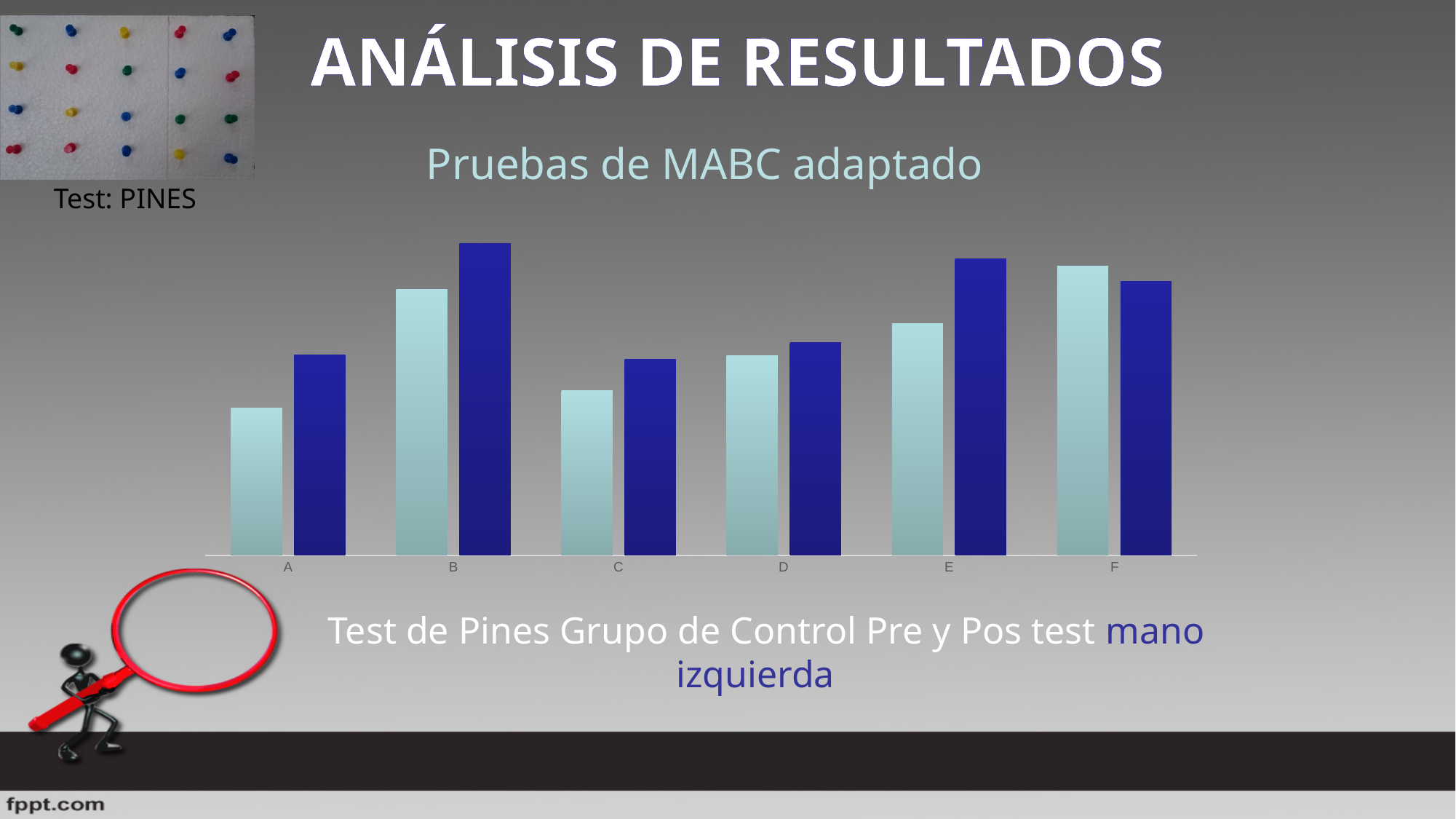
What kind of chart is shown on the slide? bar chart How many bars are plotted for each category in the chart? 2 How many bars are plotted in total in the chart? 12 In category A, which bar is taller, the light blue one or the dark blue one? dark blue What are the labels of the categories on the x axis, from left to right? A, B, C, D, E, F In category F, which bar is taller, the light blue one or the dark blue one? light blue In category E, which bar is taller, the light blue one or the dark blue one? dark blue Which category has the tallest light blue bar? F How many categories are shown on the x axis of the chart? 6 Which category has the tallest dark blue bar? B What is the heading shown above the chart? Pruebas de MABC adaptado Which category has the shortest light blue bar? A